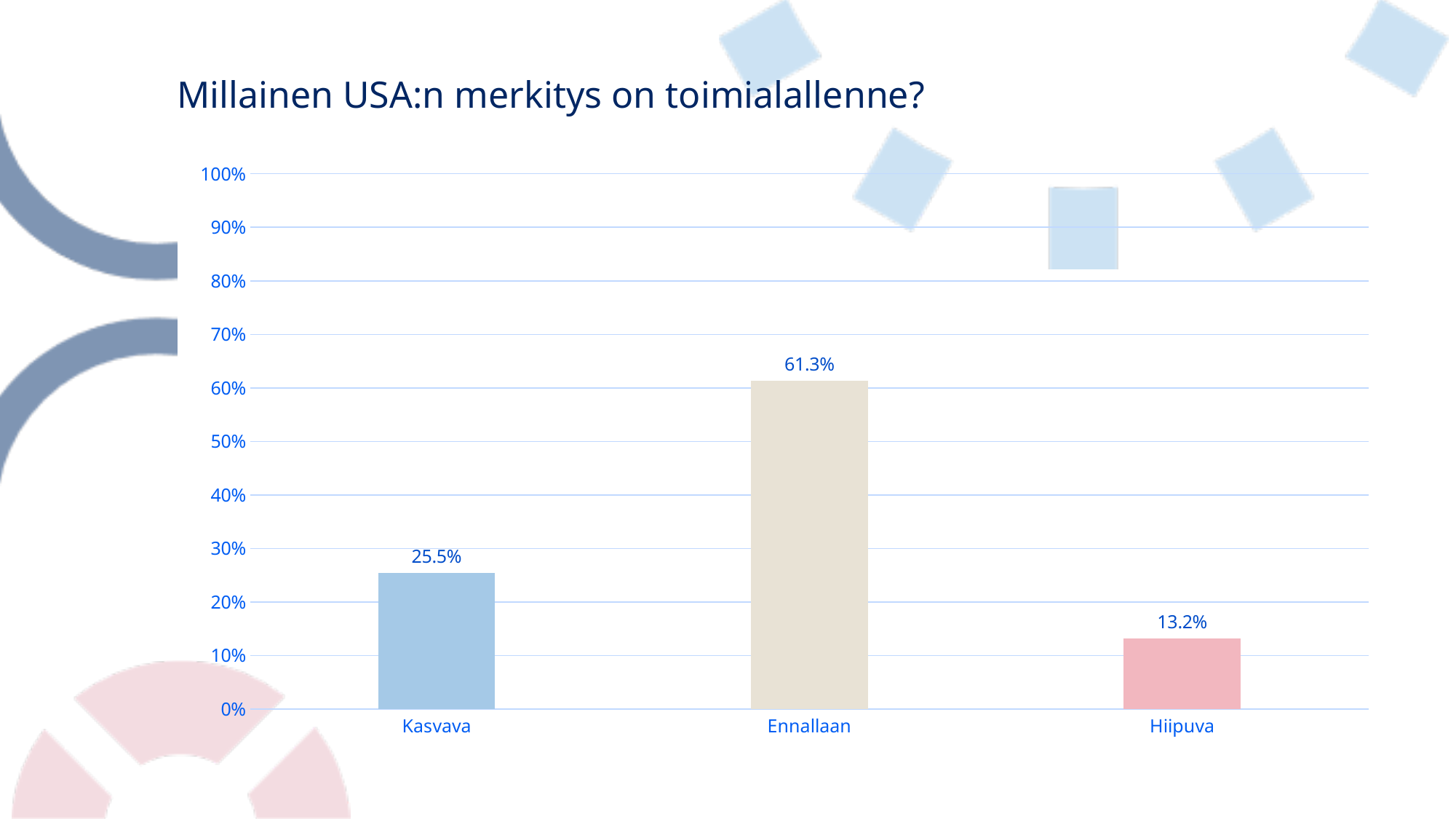
What kind of chart is shown on the slide? bar chart What is the title of the slide? Millainen USA:n merkitys on toimialallenne? Which category has the highest value? Ennallaan What is the difference between the values for Kasvava and Hiipuva? 12.3% What is the value for Ennallaan? 61.3% What is the value for Hiipuva? 13.2% How many categories are shown on the x axis? 3 What is the value for Kasvava? 25.5% What is the difference between the values for Ennallaan and Kasvava? 35.8% Which category has the lowest value? Hiipuva Which is larger, the value for Kasvava or the value for Hiipuva? Kasvava Is the value for Ennallaan greater or less than 50%? greater